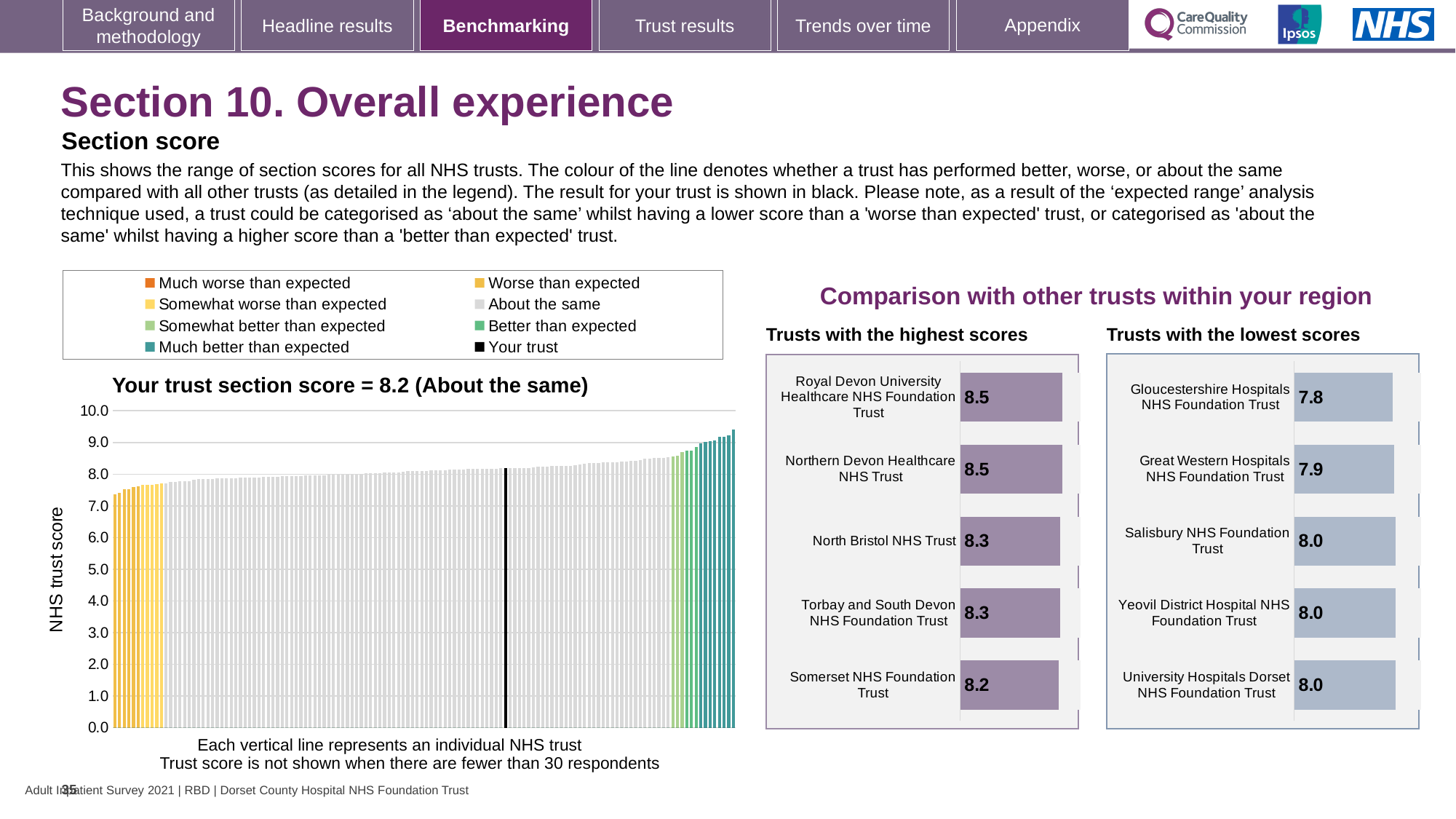
How many trusts are shown in the 'Trusts with the highest scores' chart? 5 According to the title of the left chart, what is your trust's section score? 8.2 What kind of chart is the 'Your trust section score' chart on the left? Bar chart How many entries does the legend above the 'Your trust section score' chart list? 8 In the 'Trusts with the highest scores' chart, what is the difference between the score for Royal Devon University Healthcare NHS Foundation Trust and the score for Somerset NHS Foundation Trust? 0.3 In the 'Your trust section score' chart, is the value of the leftmost bar greater or less than 8.0? less In the 'Your trust section score' chart, do the bar values rise or fall from left to right along the x axis? Rise In the 'Trusts with the lowest scores' chart, which trust has the lowest score? Gloucestershire Hospitals NHS Foundation Trust In the 'Trusts with the highest scores' chart, what is the score for North Bristol NHS Trust? 8.3 In the 'Trusts with the lowest scores' chart, which has the larger score: Gloucestershire Hospitals NHS Foundation Trust or Great Western Hospitals NHS Foundation Trust? Great Western Hospitals NHS Foundation Trust In the 'Trusts with the lowest scores' chart, what is the score for Great Western Hospitals NHS Foundation Trust? 7.9 In the 'Trusts with the lowest scores' chart, how many trusts have a score of 8.0? 3